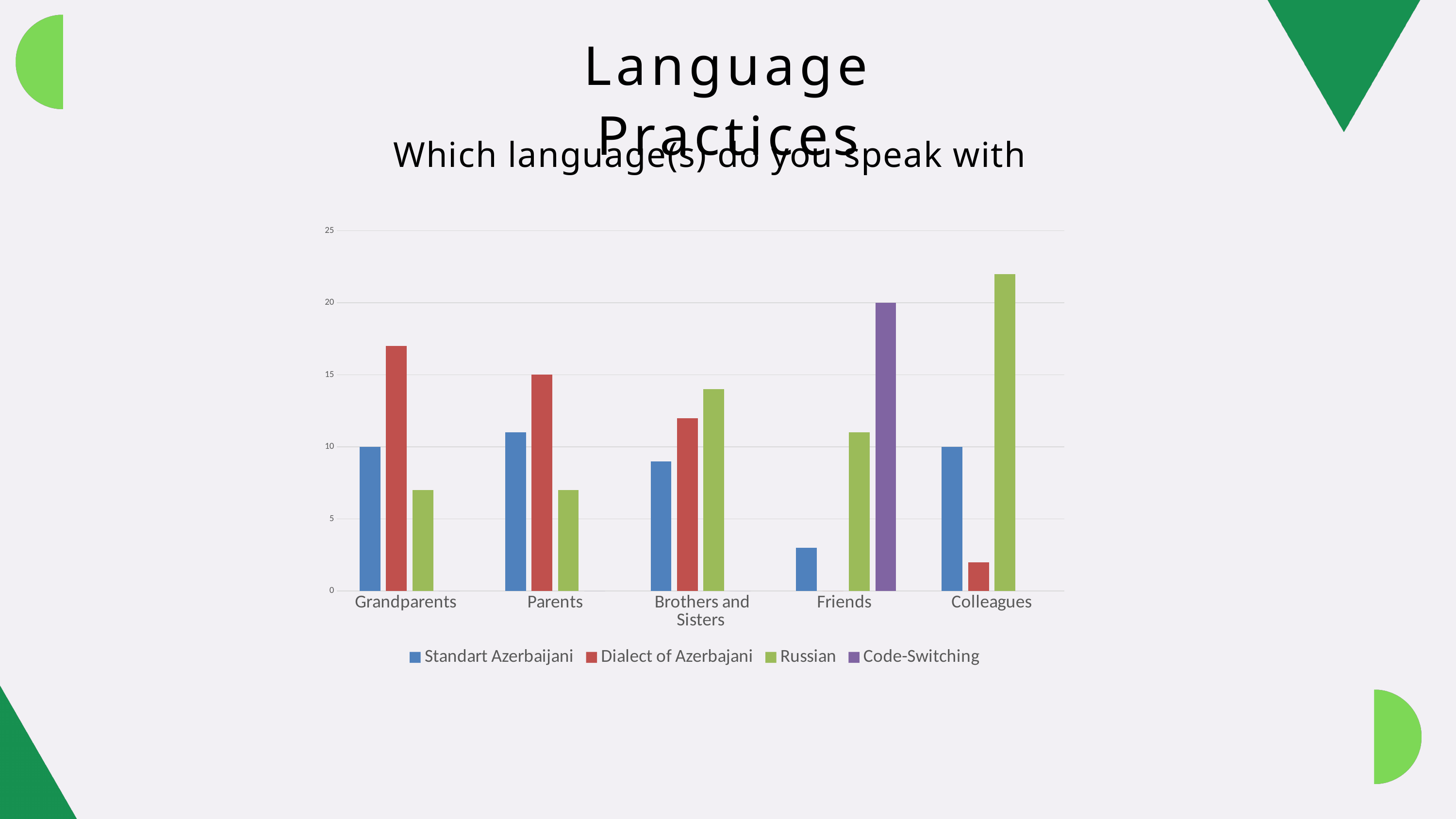
What is the value for Standart Azerbaijani with Grandparents? 10 What is the value for Code-Switching with Friends? 20 Which category has the highest Russian value? Colleagues Is the value for Standart Azerbaijani with Friends greater or less than 5? less What kind of chart is shown on the slide? bar chart How many categories are shown on the x axis? 5 Which is larger for Brothers and Sisters: Russian or Standart Azerbaijani? Russian What is the value for Dialect of Azerbajani with Parents? 15 How many series does the legend list? 4 Which category has the lowest Standart Azerbaijani value? Friends Is the value for Dialect of Azerbajani with Grandparents greater or less than 15? greater Is the value for Russian with Colleagues greater or less than 20? greater